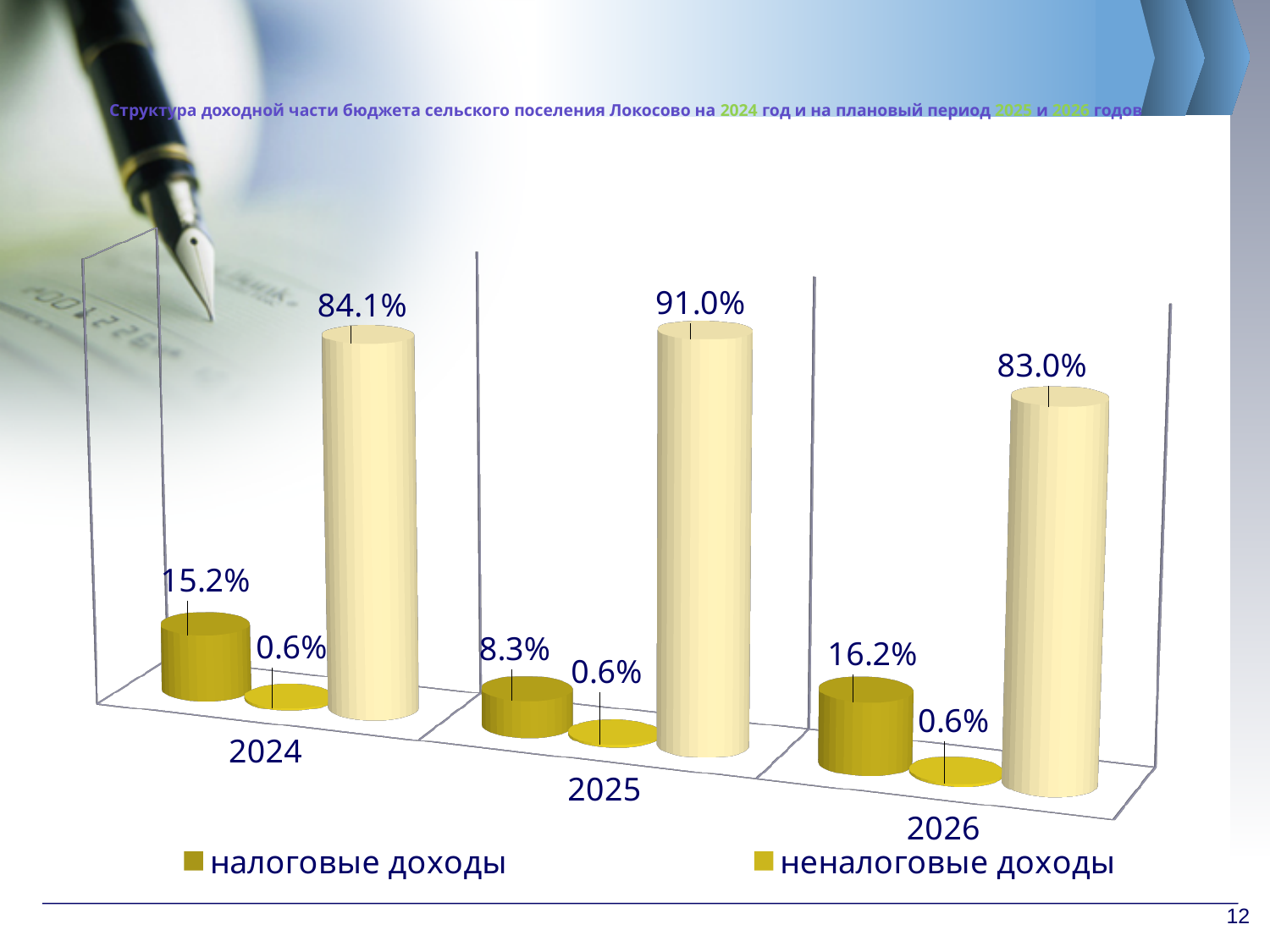
How many series does the legend list? 2 What is the value for налоговые доходы in 2025? 8.3% What is the value for налоговые доходы in 2024? 15.2% What is the value for налоговые доходы in 2026? 16.2% What is the value for неналоговые доходы in 2025? 0.6% What is the difference between the налоговые доходы values for 2026 and 2025? 7.9% What kind of chart is shown on the slide? bar chart Which is larger: налоговые доходы in 2024 or in 2026? 2026 What is the largest value labelled for 2025? 91.0% How many years are shown on the x axis of the chart? 3 In which year is the value for налоговые доходы the lowest? 2025 In which year is the value for налоговые доходы the highest? 2026